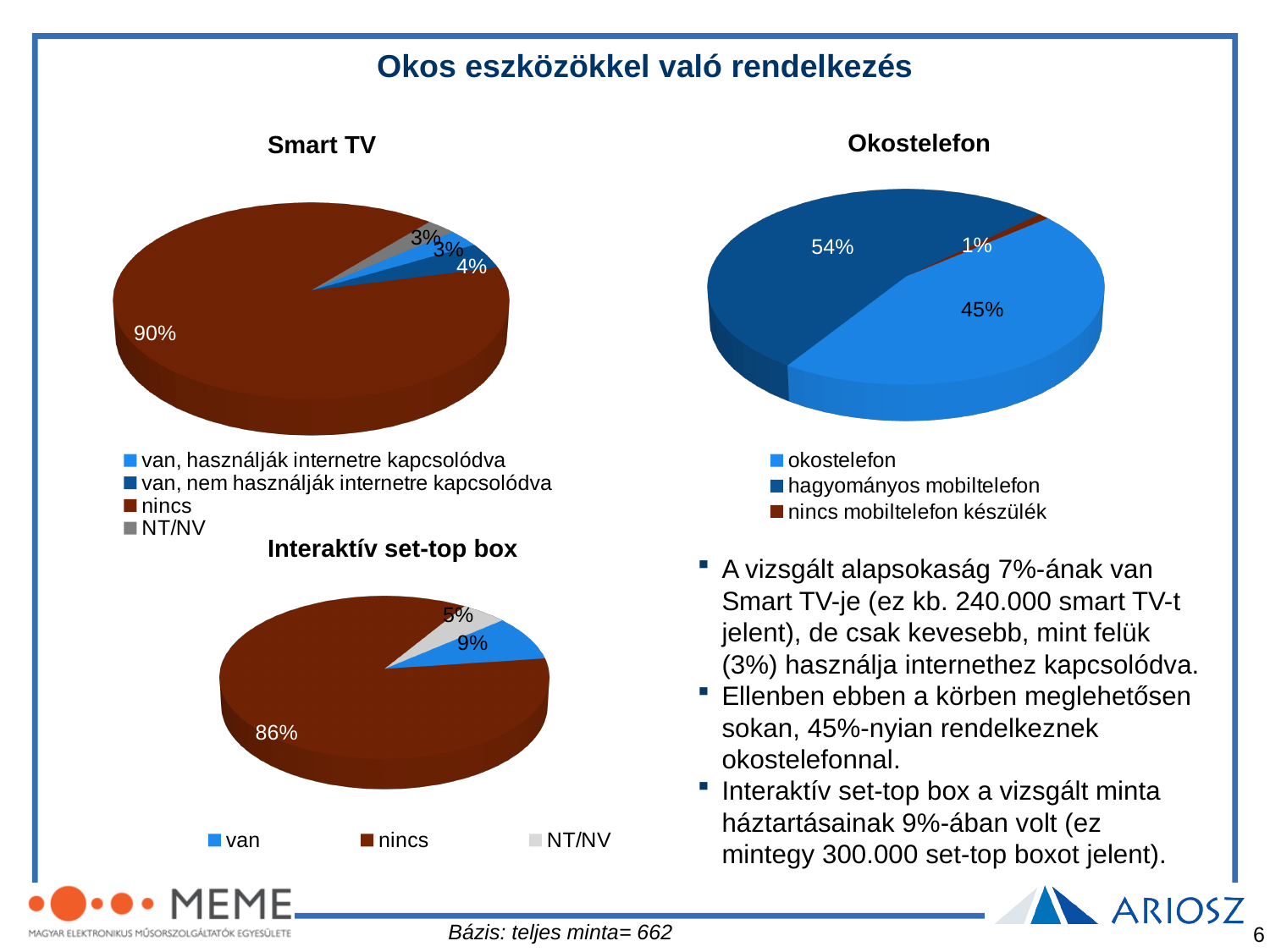
In the Okostelefon chart, which category has the smallest slice? nincs mobiltelefon készülék In the Okostelefon chart, what share is labelled for 'okostelefon'? 45% In the Interaktív set-top box chart, which is larger: 'van' or 'NT/NV'? van What type of chart is the Okostelefon chart? Pie chart In the Interaktív set-top box chart, which category has the largest slice? nincs In the Interaktív set-top box chart, what share is labelled for 'van'? 9% In the Smart TV chart, what share is labelled for the 'nincs' slice? 90% In the Okostelefon chart, what is the difference between the 'hagyományos mobiltelefon' and 'okostelefon' shares? 9 percentage points In the Okostelefon chart, what share is labelled for 'nincs mobiltelefon készülék'? 1% In the Interaktív set-top box chart, what share is labelled for 'NT/NV'? 5% How many categories does the legend of the Smart TV chart list? 4 In the Okostelefon chart, what share is labelled for 'hagyományos mobiltelefon'? 54%